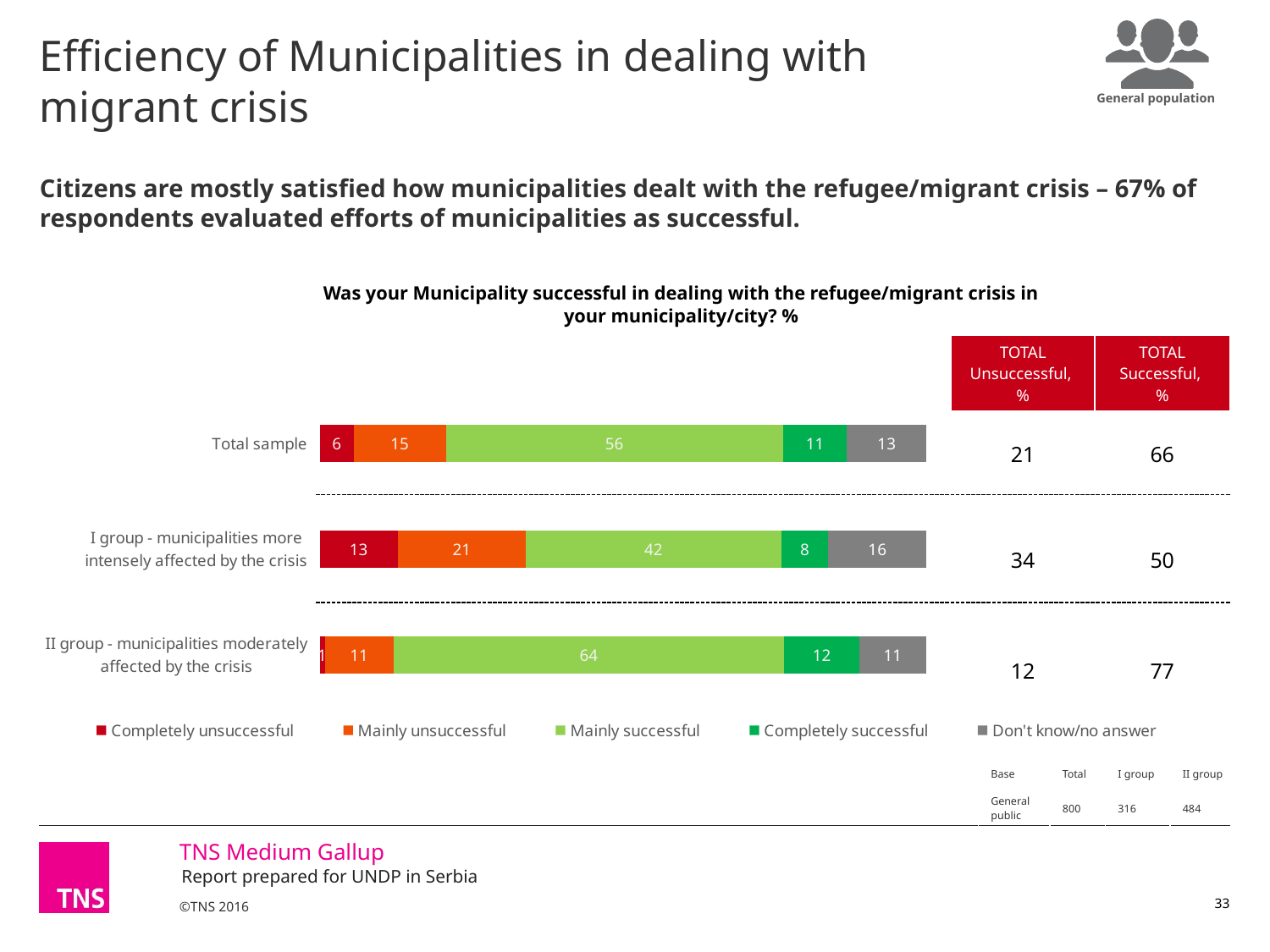
What is the 'Mainly unsuccessful' value for I group - municipalities more intensely affected by the crisis? 21 Which category has the highest 'Mainly successful' value? II group - municipalities moderately affected by the crisis Which category has the lowest 'Completely successful' value? I group - municipalities more intensely affected by the crisis What is the 'Completely successful' value for II group - municipalities moderately affected by the crisis? 12 What is the difference between the 'Mainly successful' values for II group and I group? 22 How many categories (groups) are plotted in the chart? 3 What is the title of the chart? Was your Municipality successful in dealing with the refugee/migrant crisis in your municipality/city? % What is the 'Don't know/no answer' value for I group? 16 What is the 'Mainly successful' value for the Total sample? 56 What kind of chart is shown on the slide? Stacked bar chart Is the 'Completely unsuccessful' value larger for the Total sample or for I group? I group How many series does the chart legend list? 5